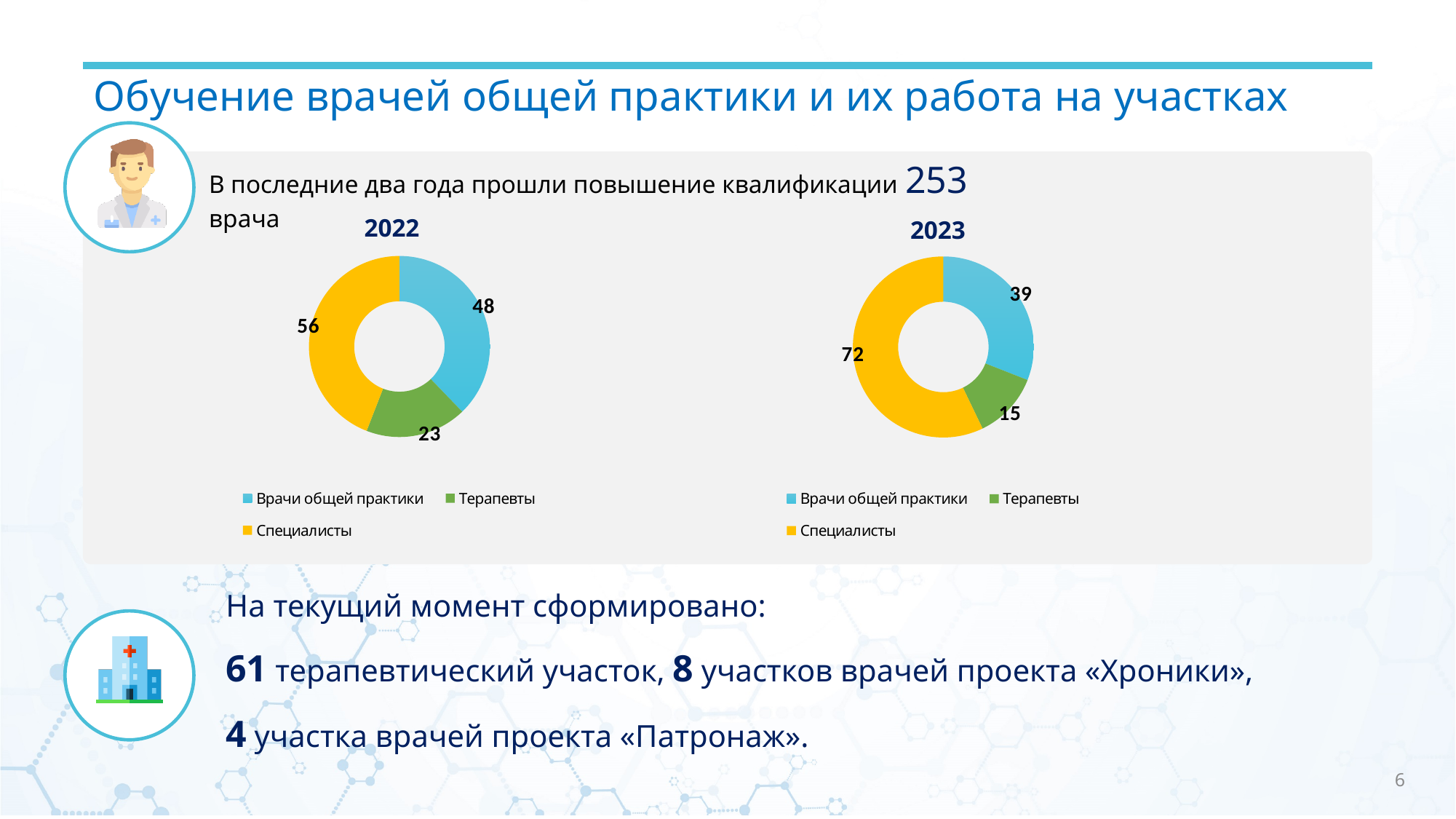
What is the total of all values in the 2022 chart? 127 What is the total of all values in the 2023 chart? 126 How many categories does the 2023 chart show? 3 In the 2023 chart, which category has the largest value? Специалисты In the 2023 chart, what colour represents Терапевты? Green In the 2022 chart, what is the value for Врачи общей практики? 48 In the 2023 chart, what is the difference between Специалисты and Врачи общей практики? 33 In the 2022 chart, what is the value for Терапевты? 23 What type of chart is the 2022 chart? Doughnut chart In the 2023 chart, what is the value for Специалисты? 72 In the 2022 chart, which is larger: Специалисты or Врачи общей практики? Специалисты In the 2022 chart, which category has the smallest value? Терапевты